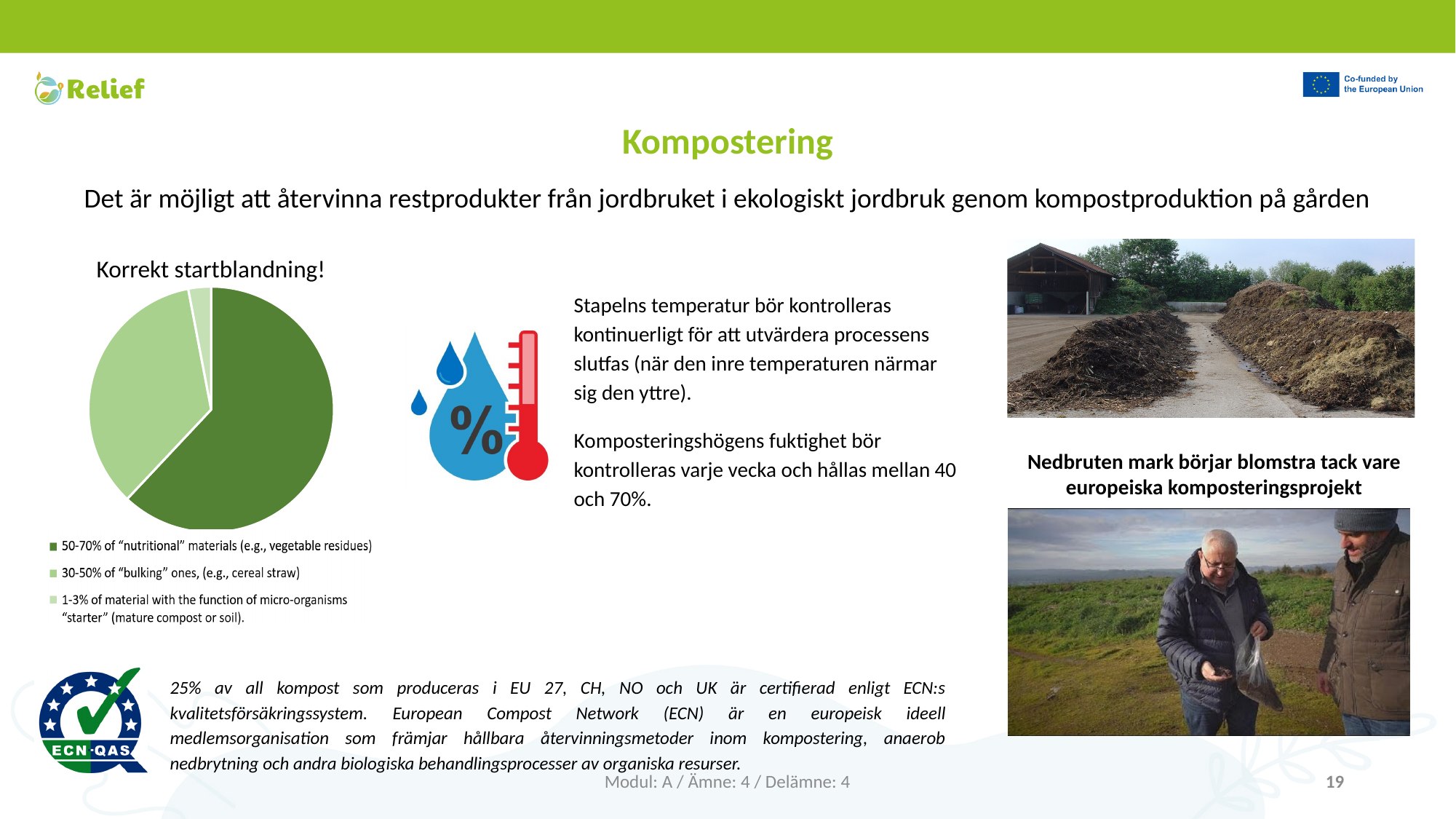
What kind of chart is shown under the heading "Korrekt startblandning!"? pie chart What is the title shown above the pie chart? Korrekt startblandning! Does the largest slice of the pie chart cover more or less than half of the pie? more How many slices does the pie chart have? 3 In the pie chart, which slice is larger: the "bulking" ones slice or the micro-organisms "starter" slice? 30-50% of "bulking" ones, (e.g., cereal straw) Which legend category takes up the smallest slice of the pie chart? 1-3% of material with the function of micro-organisms "starter" (mature compost or soil) How many entries does the legend of the pie chart list? 3 Which legend category is shown in the darkest green colour in the pie chart? 50-70% of "nutritional" materials (e.g., vegetable residues) Which legend category takes up the largest slice of the pie chart? 50-70% of "nutritional" materials (e.g., vegetable residues) In the pie chart, which slice is larger: the "nutritional" materials slice or the "bulking" ones slice? 50-70% of "nutritional" materials (e.g., vegetable residues)